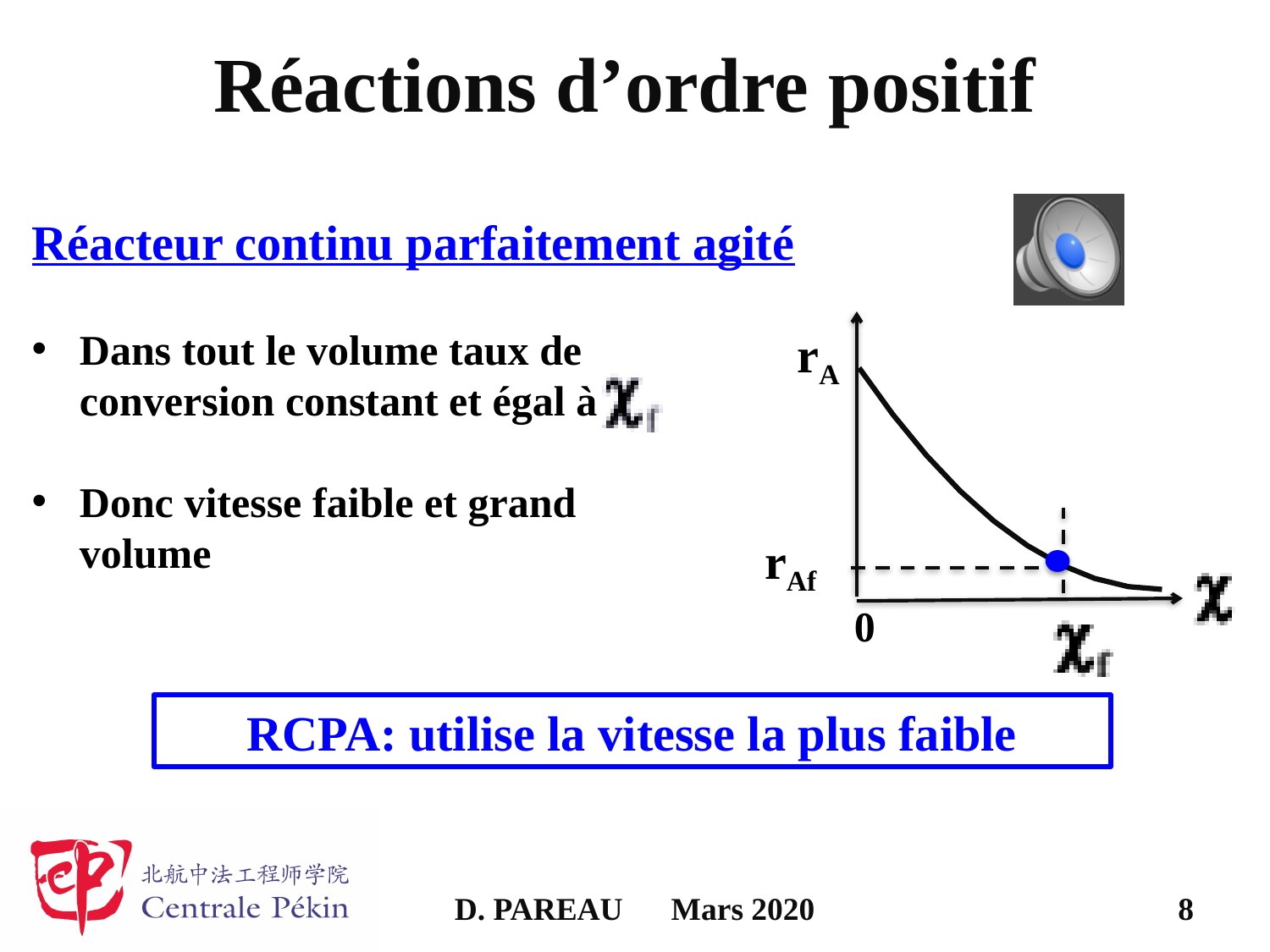
Does the curve rise or fall as χ increases along the x axis? fall What is the label on the horizontal axis of the chart? χ Which is larger, the value of rA at χ = 0 or the value rAf at χf? rA at χ = 0 How many data points are marked with a dot on the curve? 1 What value on the y axis corresponds to the marked point? rAf What kind of chart is shown on the right of the slide? line chart What number is written at the origin of the x axis? 0 What value on the x axis is the marked point located at? χf What is the label on the vertical axis of the chart? rA